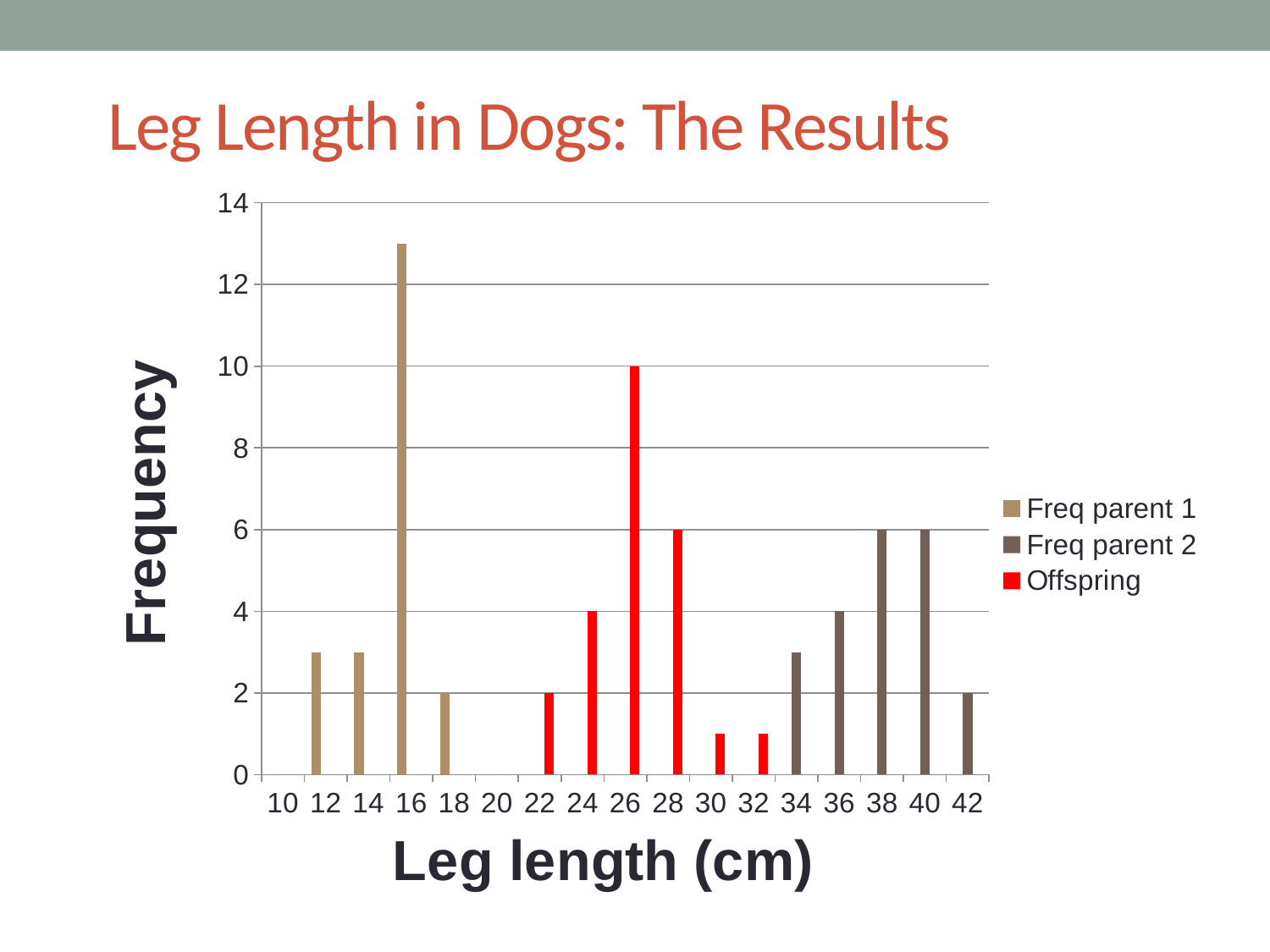
What is the frequency for Freq parent 1 at a leg length of 18 cm? 2 What is the frequency for the Offspring series at a leg length of 26 cm? 10 At which leg length does the Freq parent 1 series reach its highest frequency? 16 What is the difference between the Offspring frequency at 26 cm and at 28 cm? 4 Is the frequency for Freq parent 1 at 16 cm greater or less than 12? greater Is the frequency for the Offspring series at 30 cm greater or less than 2? less What is the frequency for Freq parent 2 at a leg length of 38 cm? 6 Which is larger: the Offspring frequency at 26 cm or the Freq parent 2 frequency at 38 cm? Offspring at 26 cm At which leg length does the Offspring series reach its highest frequency? 26 How many series does the legend list? 3 What is the frequency for the Offspring series at a leg length of 28 cm? 6 What kind of chart is shown on the slide? bar chart